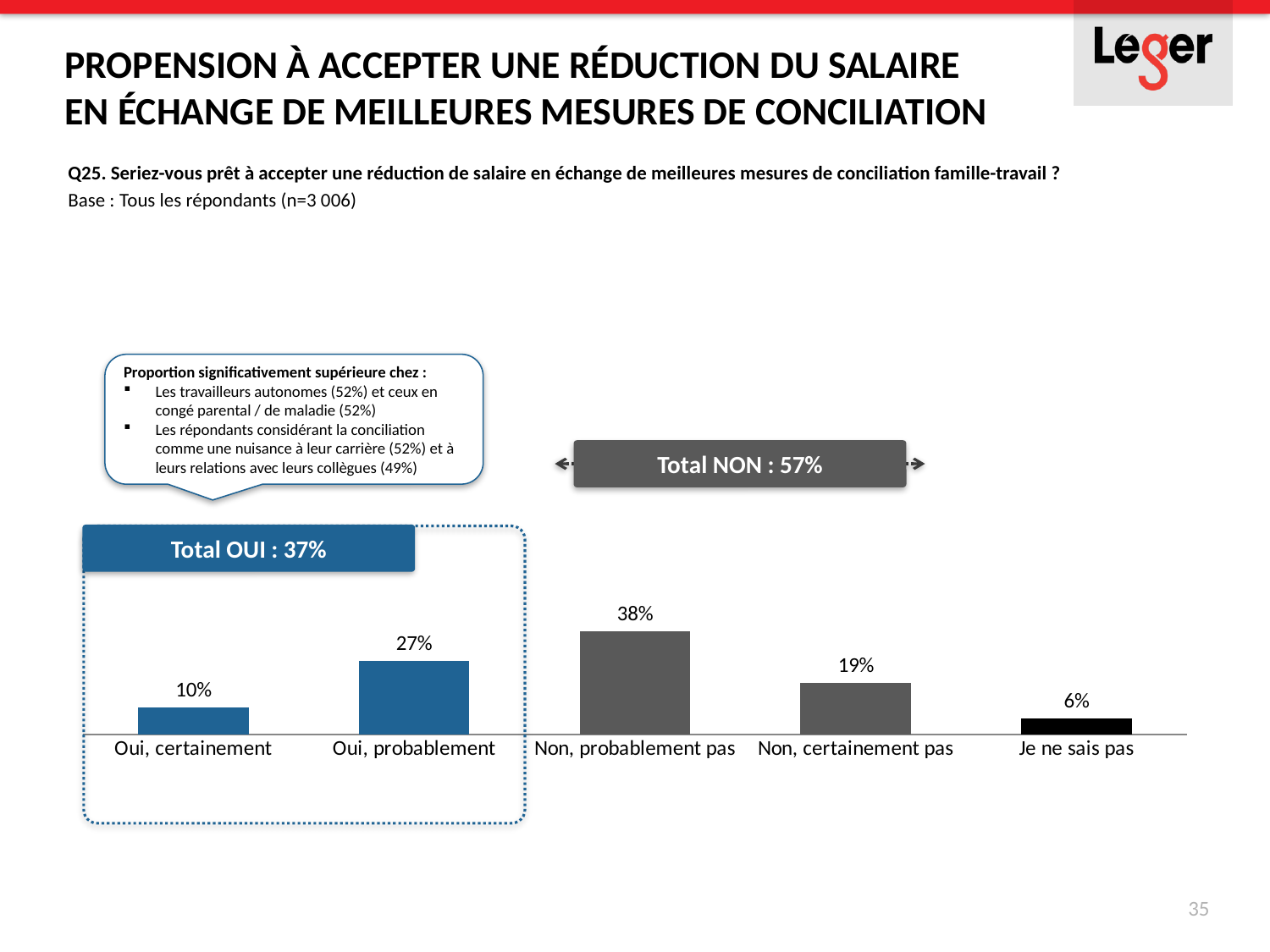
What is the value for "Oui, certainement"? 10% What is the difference between "Non, probablement pas" and "Oui, probablement"? 11 percentage points Which category has the highest value? Non, probablement pas Which is larger, "Oui, probablement" or "Non, certainement pas"? Oui, probablement Which category has the lowest value? Je ne sais pas What is the Total NON percentage shown on the slide? 57% What is the value for "Non, certainement pas"? 19% What kind of chart is shown on the slide? Bar chart How many categories are shown in the chart? 5 What is the value for "Je ne sais pas"? 6% What is the value for "Non, probablement pas"? 38% What is the value for "Oui, probablement"? 27%